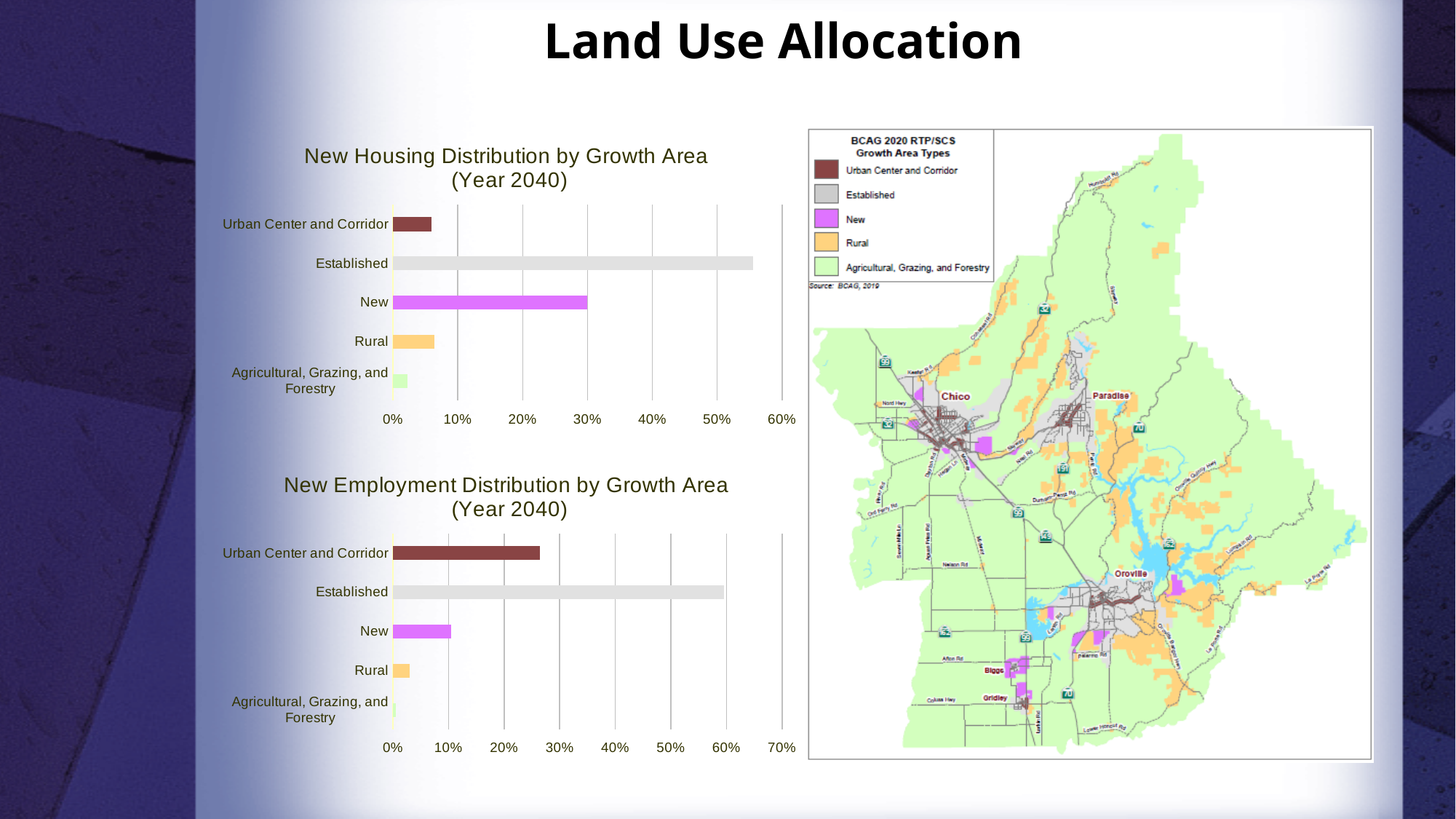
In the New Housing Distribution by Growth Area (Year 2040) chart, which growth area has the lowest share? Agricultural, Grazing, and Forestry In the New Employment Distribution by Growth Area (Year 2040) chart, which growth area has the lowest share? Agricultural, Grazing, and Forestry In the New Employment Distribution by Growth Area (Year 2040) chart, which growth area has the highest share? Established In the New Housing Distribution by Growth Area (Year 2040) chart, is the value for Urban Center and Corridor greater or less than 10%? less In the New Housing Distribution by Growth Area (Year 2040) chart, which is larger, New or Rural? New How many growth area categories are shown in the New Housing Distribution by Growth Area (Year 2040) chart? 5 In the New Housing Distribution by Growth Area (Year 2040) chart, which growth area has the highest share? Established What type of chart is the New Employment Distribution by Growth Area (Year 2040) chart? Bar chart What is the maximum value shown on the x axis of the New Employment Distribution by Growth Area (Year 2040) chart? 70% In the New Housing Distribution by Growth Area (Year 2040) chart, is the value for Established greater or less than 50%? greater In the New Employment Distribution by Growth Area (Year 2040) chart, is the value for Urban Center and Corridor greater or less than 20%? greater In the New Employment Distribution by Growth Area (Year 2040) chart, which is larger, Urban Center and Corridor or New? Urban Center and Corridor